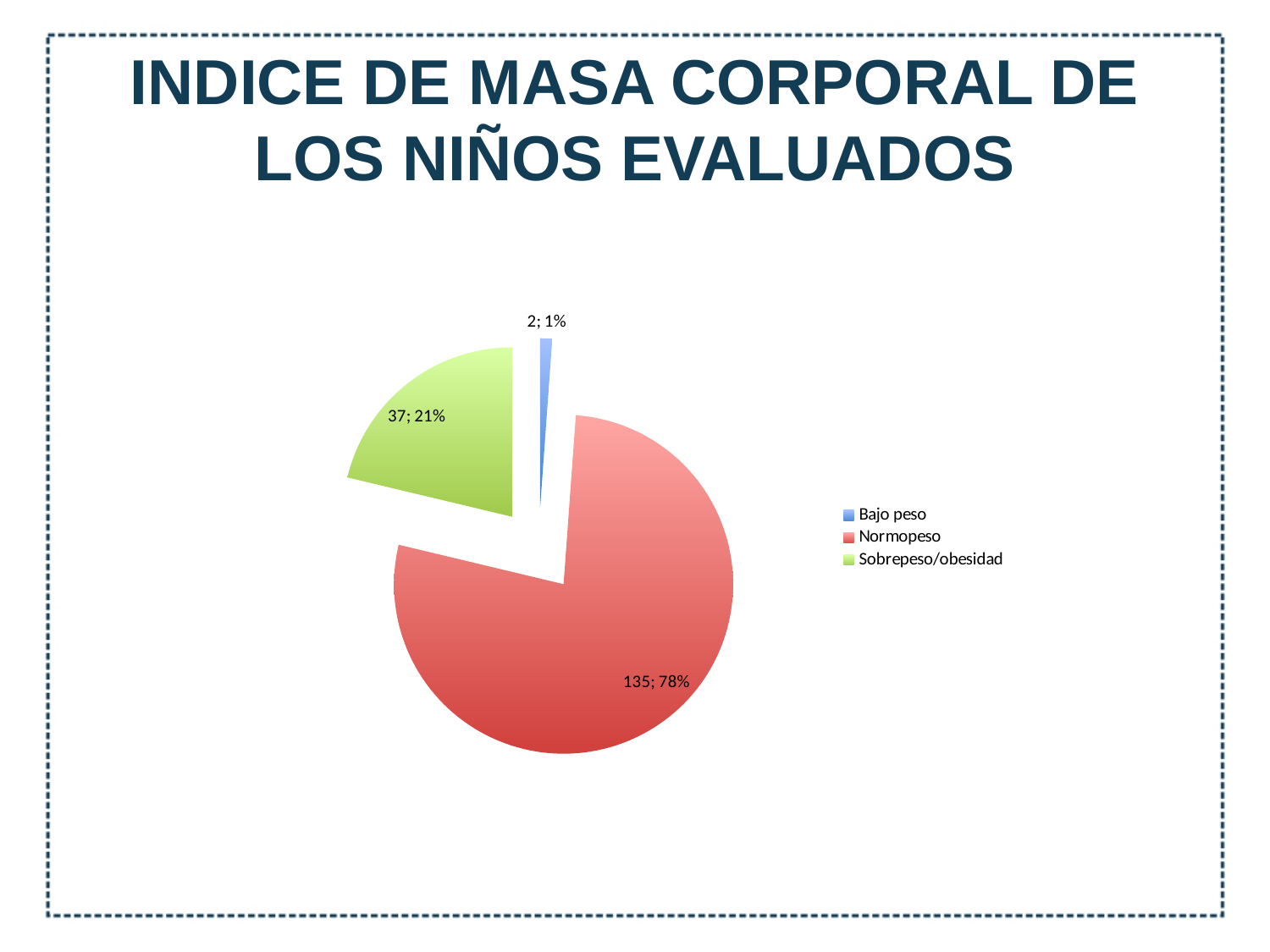
How many children are in the Bajo peso category? 2 Which category has the smallest slice? Bajo peso What share of the pie does Normopeso represent? 78% What is the difference in number of children between Normopeso and Sobrepeso/obesidad? 98 How many categories does the pie chart have? 3 What kind of chart is shown on the slide? pie chart What share of the pie does Sobrepeso/obesidad represent? 21% What share of the pie does Bajo peso represent? 1% How many children are in the Normopeso category? 135 Which category has the largest slice? Normopeso How many children are in the Sobrepeso/obesidad category? 37 What is the total number of children across all slices? 174